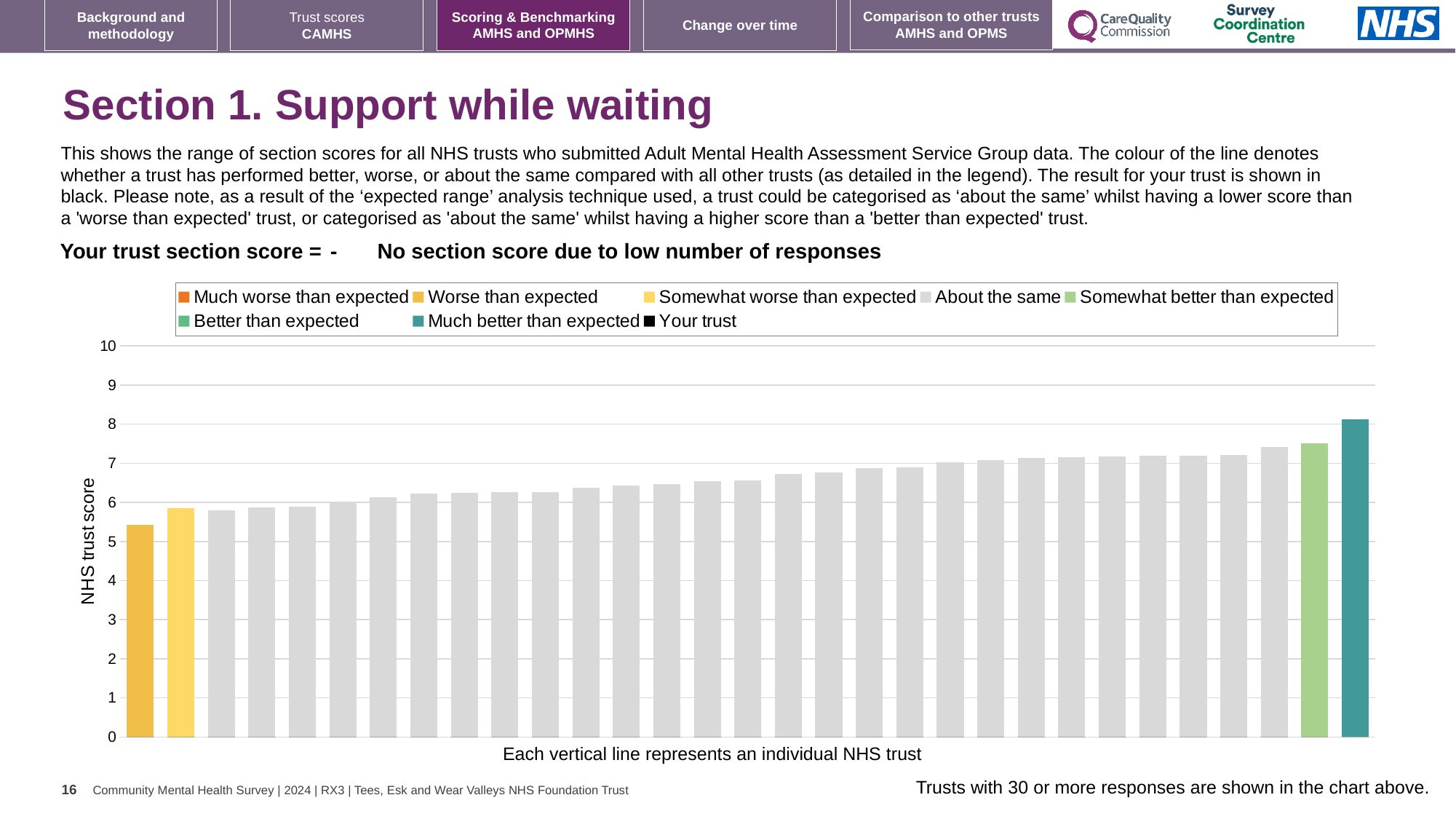
Is the value of the tallest bar (the rightmost, teal bar) greater or less than 7? greater Which is larger: the 'Worse than expected' bar or the 'Much better than expected' bar? Much better than expected What kind of chart is shown on the slide? bar chart How many entries does the chart legend list? 8 Is the value of the shortest bar (the leftmost, orange bar) greater or less than 6? less Is the value of the 'Somewhat better than expected' (light green) bar greater or less than 7? greater What is the trust section score shown for your trust on this slide? - What is the label on the vertical axis of the chart? NHS trust score Do the bar values rise or fall from left to right along the x axis? rise Which legend category does the shortest bar belong to? Worse than expected Which legend category does the tallest bar belong to? Much better than expected